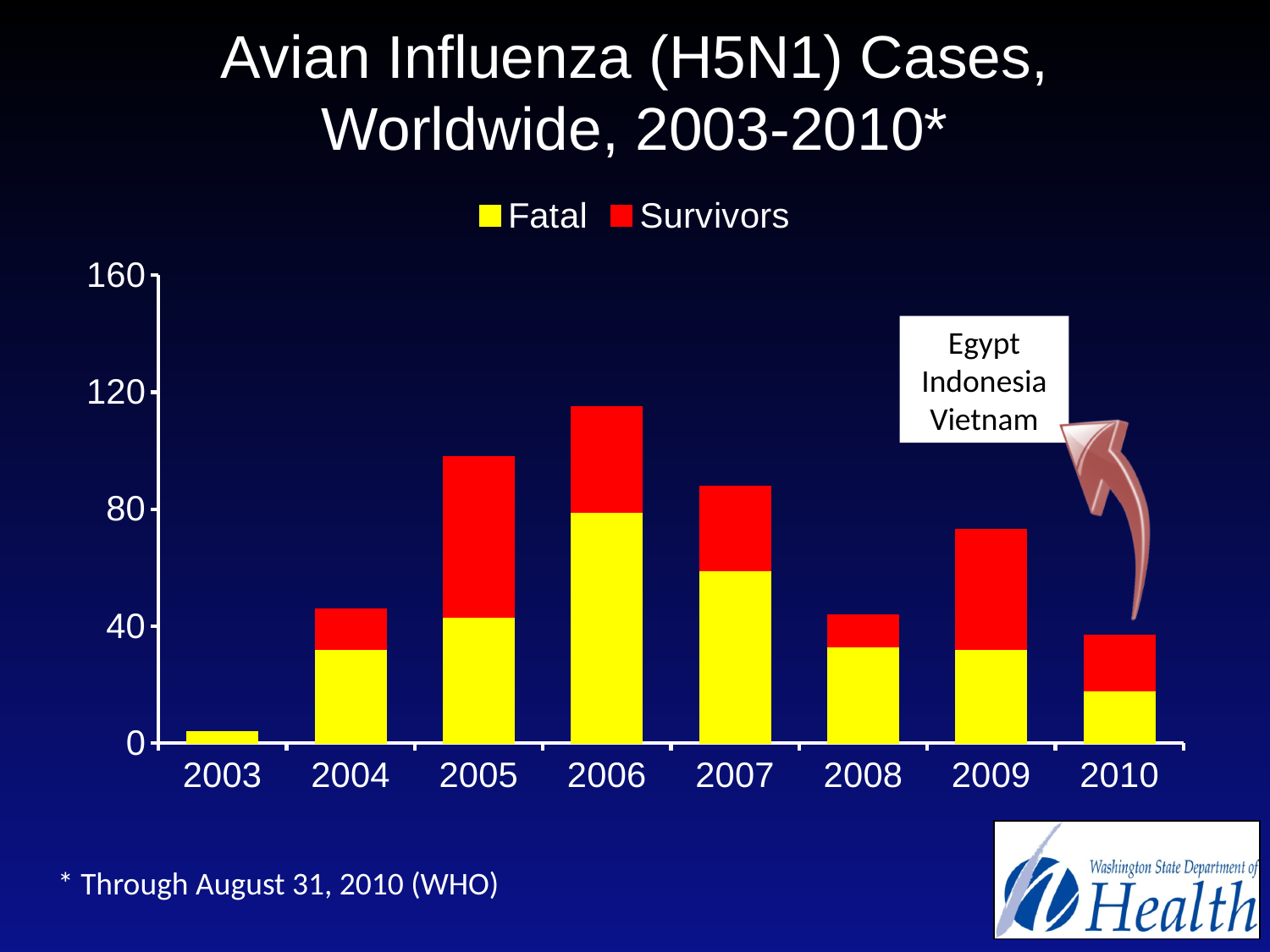
What are the two series named in the legend? Fatal and Survivors What kind of chart is shown on the slide? stacked bar chart Is the total number of cases in 2006 greater or less than 80? greater Which year has the shortest stacked bar (fewest total cases)? 2003 Is the total number of cases in 2010 greater or less than 40? less Which year had more total cases, 2005 or 2009? 2005 Which year had more fatal cases, 2007 or 2010? 2007 How many years are shown on the x axis? 8 Which year has the tallest stacked bar (most total cases)? 2006 Which colour represents the Fatal series? yellow Is the number of fatal cases in 2006 greater or less than 40? greater How many series does the legend list? 2